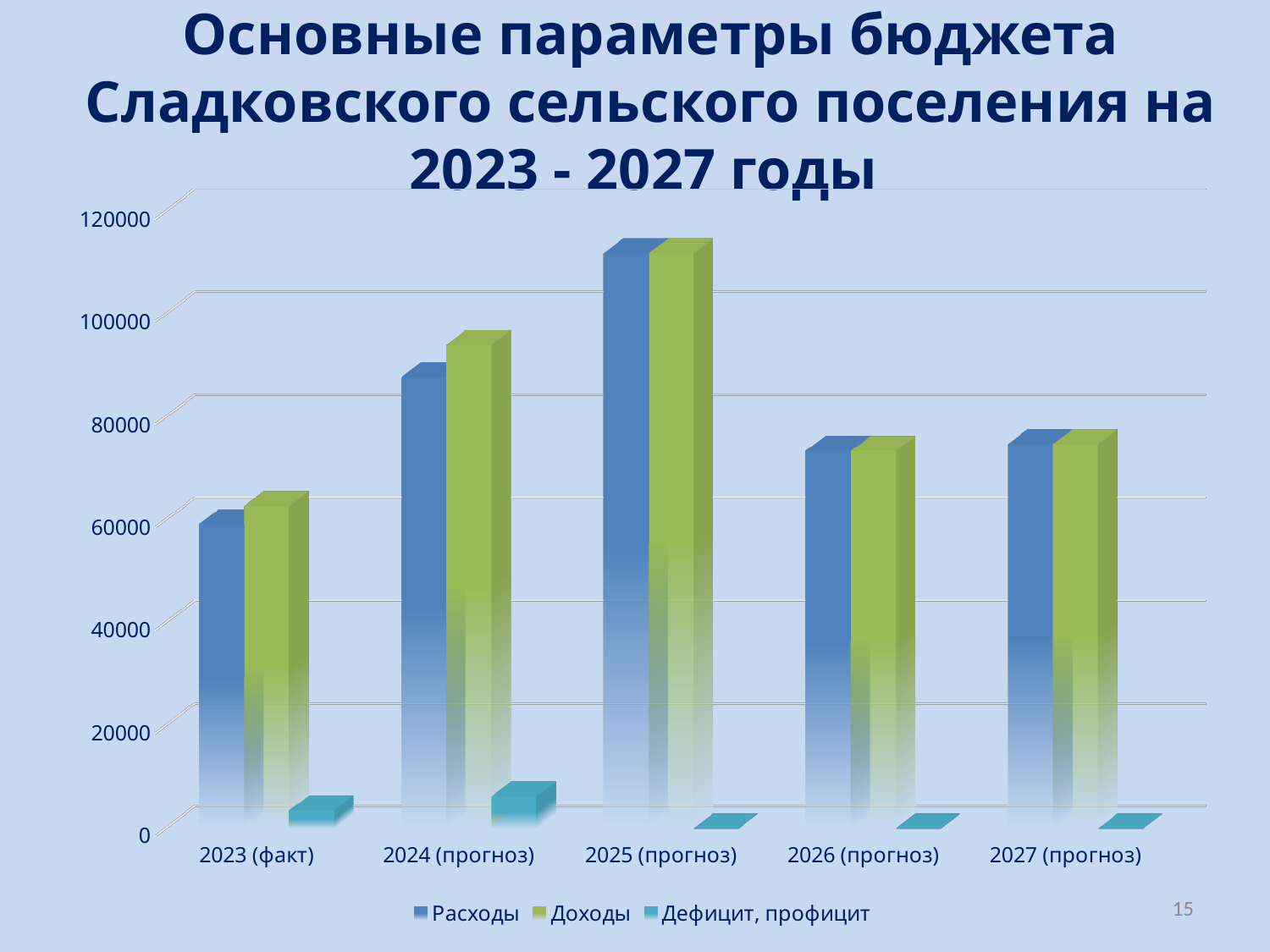
Is the value for Расходы in 2026 (прогноз) greater or less than 60000? greater What is the title of the chart? Основные параметры бюджета Сладковского сельского поселения на 2023 - 2027 годы Is the value for Расходы in 2025 (прогноз) greater or less than 100000? greater Which year has the lowest value for Доходы? 2023 (факт) In 2024 (прогноз), which is larger: Расходы or Доходы? Доходы Is the value for Дефицит, профицит in 2024 (прогноз) greater or less than 20000? less How many series does the legend list? 3 Which year has the highest value for Расходы? 2025 (прогноз) How many categories (years) are shown on the x axis? 5 What kind of chart is shown on the slide? bar chart Which series is shown in green in the legend? Доходы